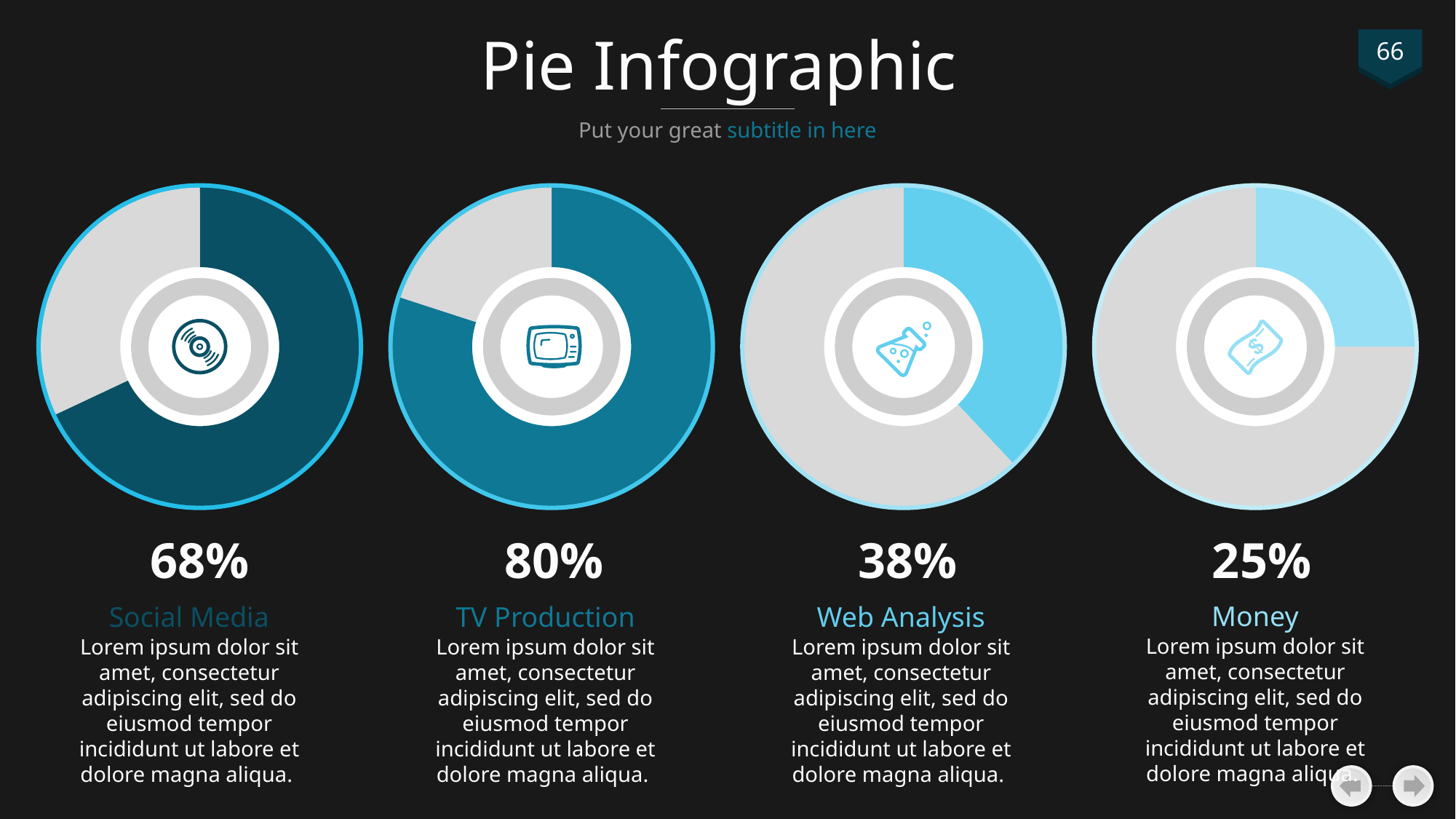
What percentage is shown for the Social Media pie chart? 68% What is the difference between the Web Analysis percentage and the Money percentage? 13% What kind of chart is used for each of the four figures on the slide? Pie chart What is the difference between the TV Production percentage and the Social Media percentage? 12% How many pie charts are shown on the slide? 4 What is the title of the slide containing the four pie charts? Pie Infographic What percentage is shown for the TV Production pie chart? 80% What percentage is shown for the Money pie chart? 25% Which of the four pie charts shows the lowest percentage? Money What percentage is shown for the Web Analysis pie chart? 38% Which of the four pie charts shows the highest percentage? TV Production Which is larger, the Social Media percentage or the Web Analysis percentage? Social Media